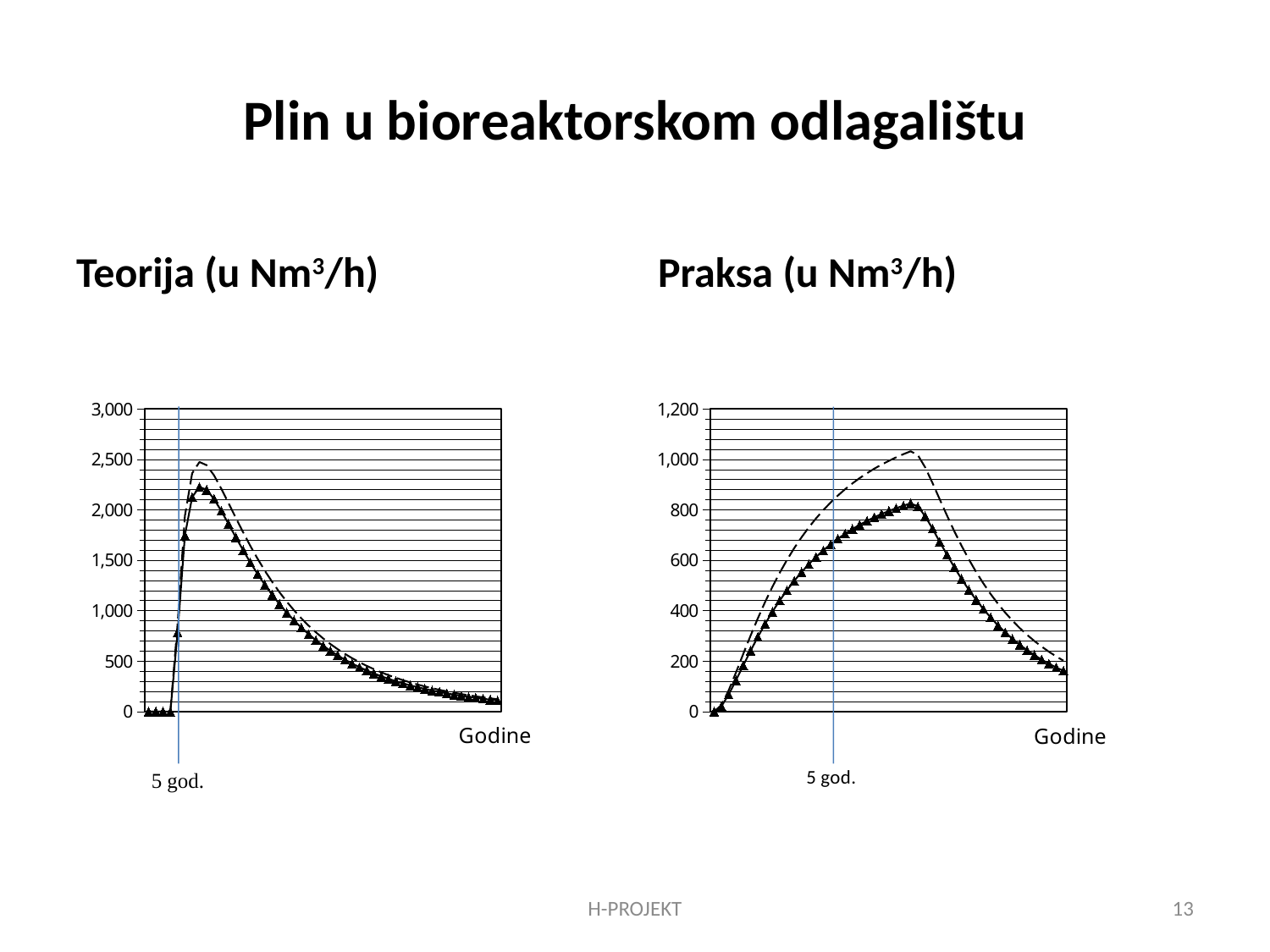
In the left chart 'Teorija (u Nm³/h)', is the peak value of the triangle-marked line greater or less than 2,500? less In the left chart 'Teorija (u Nm³/h)', is the peak value of the triangle-marked line greater or less than 2,000? greater What kind of chart is the right chart titled 'Praksa (u Nm³/h)'? line chart What kind of chart is the left chart titled 'Teorija (u Nm³/h)'? line chart In the right chart 'Praksa (u Nm³/h)', is the peak value of the triangle-marked line greater or less than 1,000? less In the right chart 'Praksa (u Nm³/h)', how many lines (series) are plotted? 2 What is the x-axis label on the left chart 'Teorija (u Nm³/h)'? Godine In the left chart 'Teorija (u Nm³/h)', do the values rise or fall along the x axis after the peak? fall What is the highest value shown on the y axis of the right chart 'Praksa (u Nm³/h)'? 1,200 In the left chart 'Teorija (u Nm³/h)', how many lines (series) are plotted? 2 In the right chart 'Praksa (u Nm³/h)', do the values rise or fall along the x axis before the 5 god. line? rise